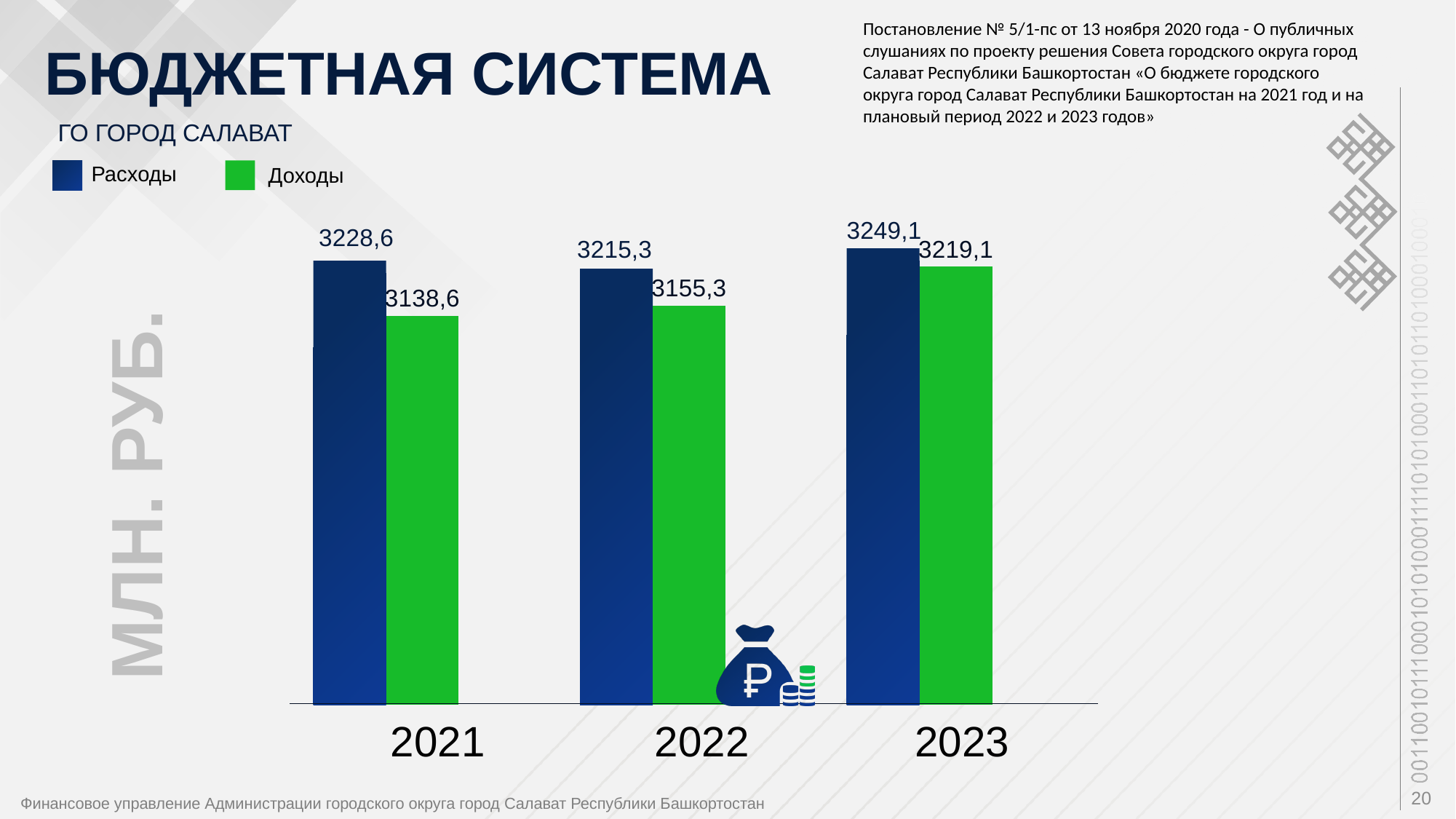
Do the Доходы values rise or fall from 2021 to 2023? rise How many series does the legend list? 2 What is the value of Расходы for 2023? 3249,1 What is the value of Доходы for 2023? 3219,1 What is the value of Расходы for 2021? 3228,6 What is the difference between Расходы and Доходы in 2023? 30,0 In which year is Доходы the highest? 2023 In which year is Доходы the lowest? 2021 What is the difference between Расходы and Доходы in 2021? 90,0 What is the value of Доходы for 2022? 3155,3 In which year is Расходы the highest? 2023 Which is larger in 2022, Расходы or Доходы? Расходы